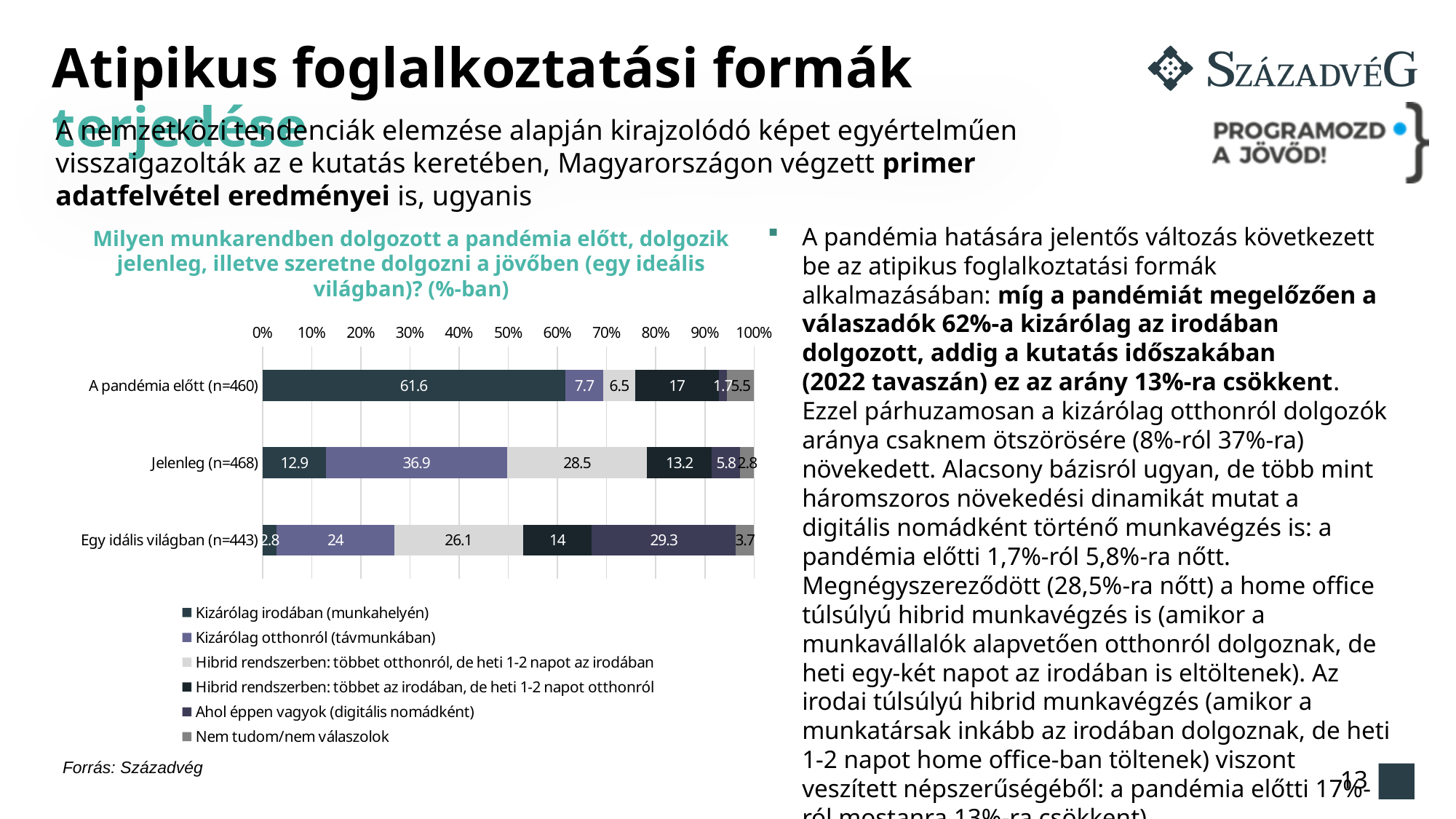
What is the title of the chart? Milyen munkarendben dolgozott a pandémia előtt, dolgozik jelenleg, illetve szeretne dolgozni a jövőben (egy ideális világban)? (%-ban) How many categories (rows) does the chart show? 3 Which is larger: the 'Kizárólag otthonról (távmunkában)' value for 'Jelenleg (n=468)' or for 'Egy idális világban (n=443)'? Jelenleg (n=468) What is the value for 'Kizárólag irodában (munkahelyén)' in the 'A pandémia előtt (n=460)' row? 61.6 Which series has the largest segment in the 'Egy idális világban (n=443)' row? Ahol éppen vagyok (digitális nomádként) What is the value for 'Hibrid rendszerben: többet otthonról, de heti 1-2 napot az irodában' in the 'Jelenleg (n=468)' row? 28.5 How many series does the legend list? 6 Which series has the smallest segment in the 'A pandémia előtt (n=460)' row? Ahol éppen vagyok (digitális nomádként) What is the value for 'Ahol éppen vagyok (digitális nomádként)' in the 'Egy idális világban (n=443)' row? 29.3 What kind of chart is shown on the slide? Stacked bar chart What is the value for 'Kizárólag otthonról (távmunkában)' in the 'Jelenleg (n=468)' row? 36.9 What is the difference between the 'Kizárólag irodában (munkahelyén)' values for 'A pandémia előtt (n=460)' and 'Jelenleg (n=468)'? 48.7